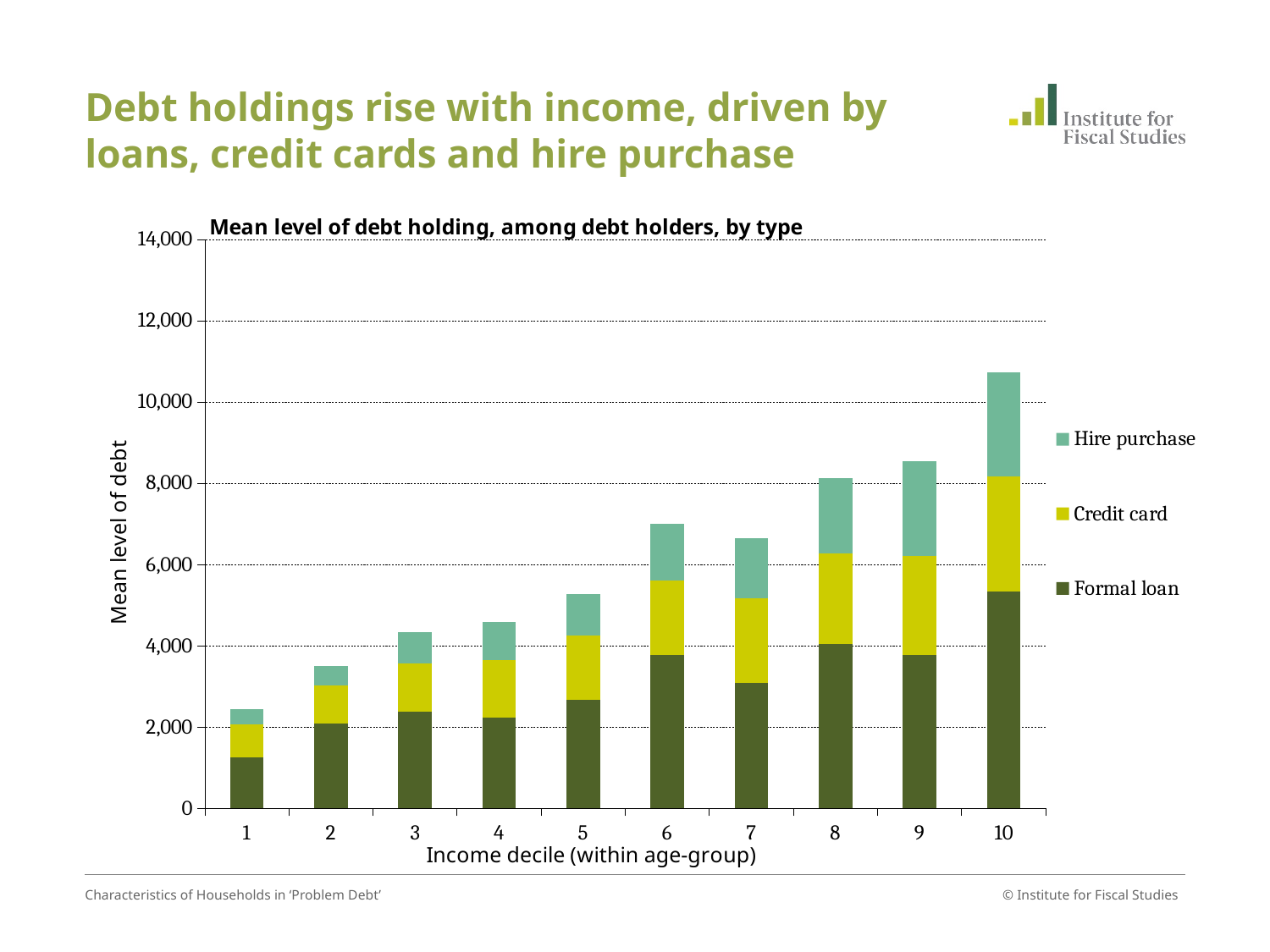
Does the total mean level of debt generally rise or fall as income decile increases? rise Is the total mean level of debt for income decile 5 greater or less than 6,000? less What kind of chart is shown on the slide? Stacked bar chart What is the title of the chart? Mean level of debt holding, among debt holders, by type How many series does the legend list? 3 Which has a larger total mean level of debt, income decile 2 or income decile 3? 3 How many income deciles are shown on the x axis? 10 Is the total mean level of debt for income decile 1 greater or less than 4,000? less Is the total mean level of debt for income decile 10 greater or less than 10,000? greater Which income decile has the lowest total mean level of debt? 1 Which income decile has the highest total mean level of debt? 10